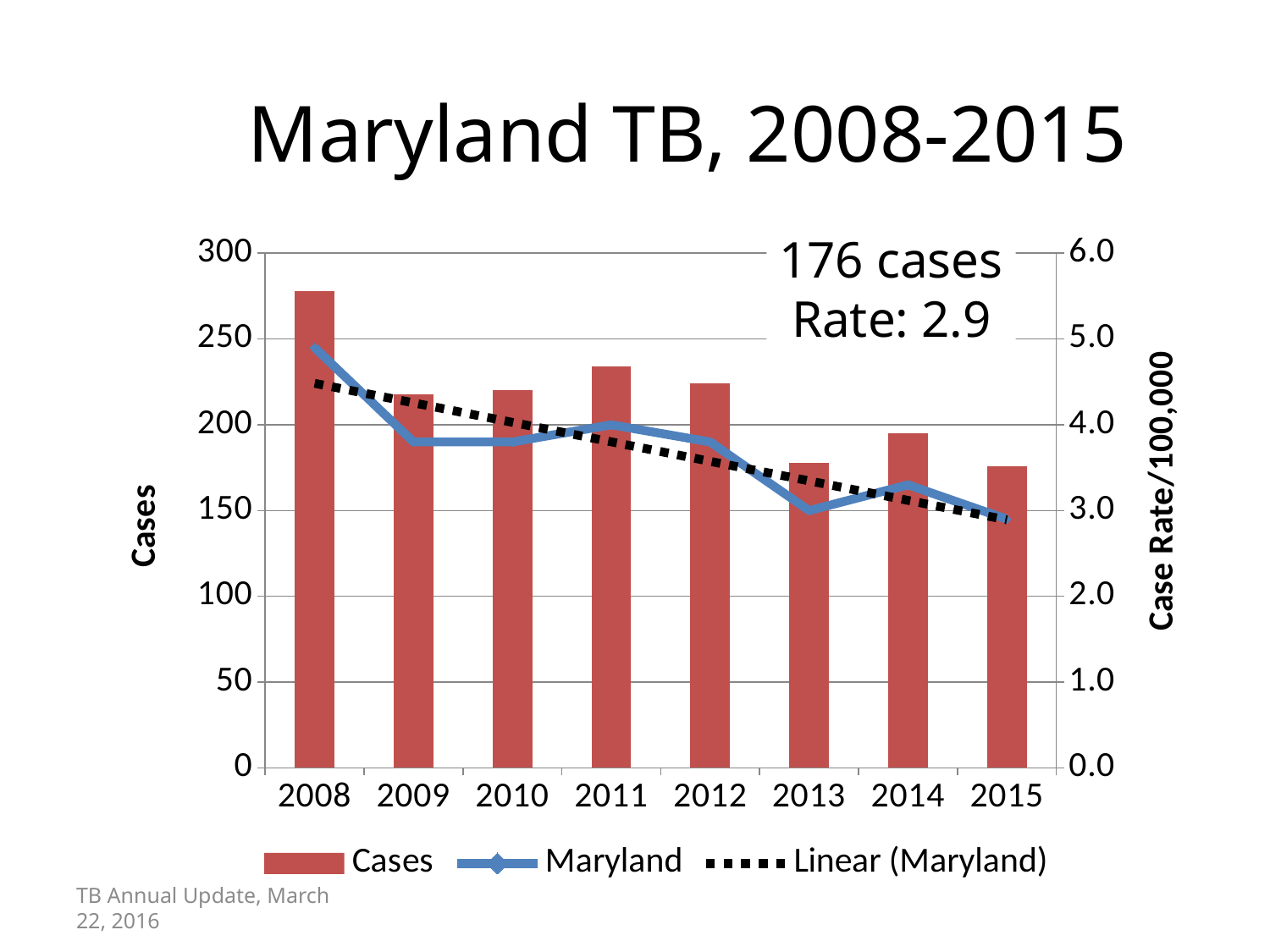
Which year has the highest Maryland case rate? 2008 Is the Maryland case rate in 2008 greater or less than 4.0? greater What number of cases and rate does the annotation on the chart state? 176 cases, Rate: 2.9 Is the Maryland case rate in 2013 greater or less than 4.0? less What type of chart is shown on the slide? A combined bar and line chart Does the Maryland case rate generally rise or fall from 2008 to 2015? Fall Which year has more cases, 2011 or 2014? 2011 How many years are shown on the x axis of the chart? 8 Is the number of cases in 2008 greater or less than 250? greater How many series does the legend list? 3 Which year has the highest number of cases (tallest bar)? 2008